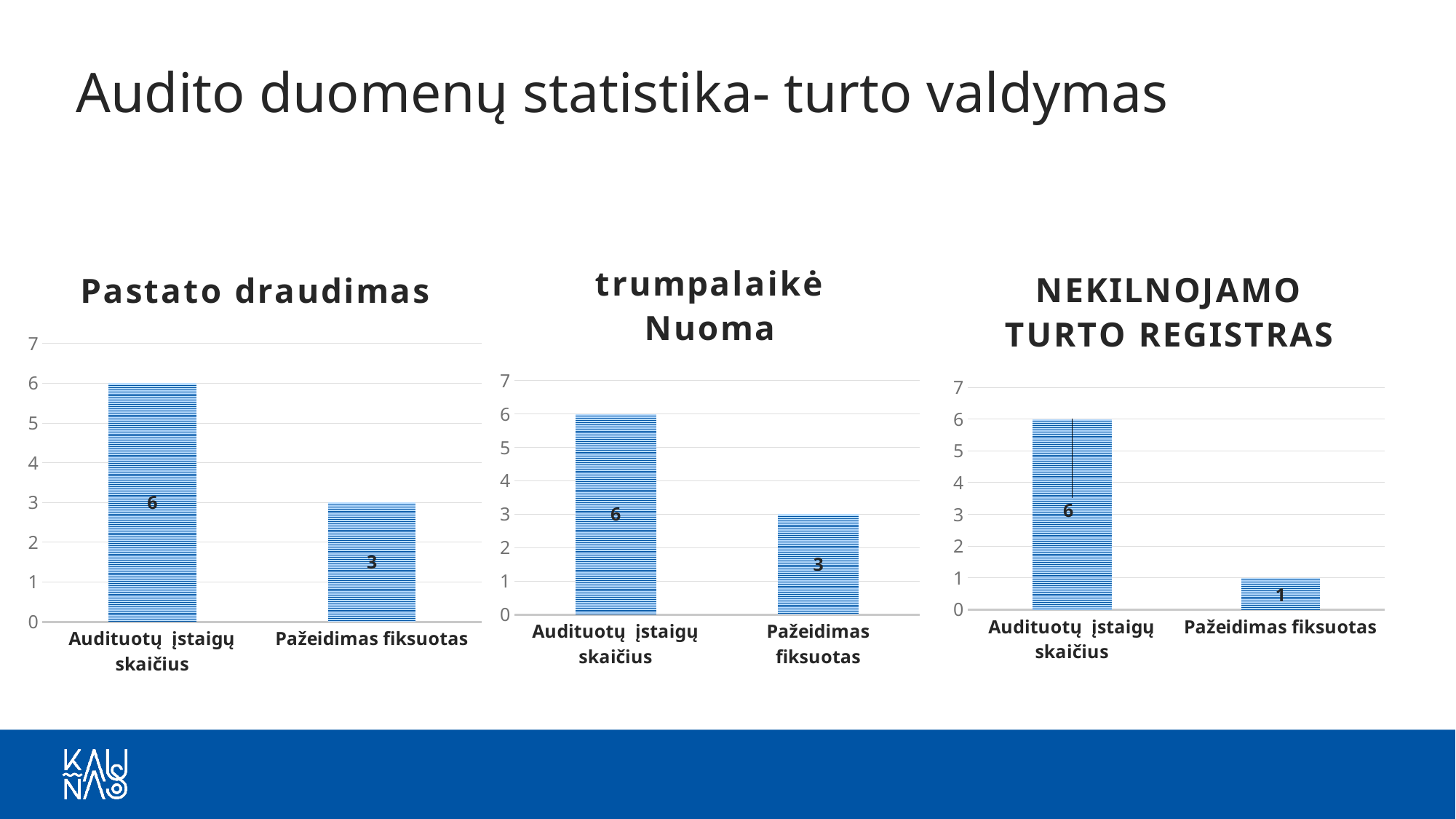
In the 'NEKILNOJAMO TURTO REGISTRAS' chart, what is the value for 'Pažeidimas fiksuotas'? 1 How many categories does the 'Pastato draudimas' chart show? 2 In the 'Pastato draudimas' chart, what is the value for 'Audituotų įstaigų skaičius'? 6 What type of chart is the 'NEKILNOJAMO TURTO REGISTRAS' chart? Bar chart In the 'Pastato draudimas' chart, what is the difference between 'Audituotų įstaigų skaičius' and 'Pažeidimas fiksuotas'? 3 In the 'NEKILNOJAMO TURTO REGISTRAS' chart, what is the difference between 'Audituotų įstaigų skaičius' and 'Pažeidimas fiksuotas'? 5 In the 'Pastato draudimas' chart, what is the value for 'Pažeidimas fiksuotas'? 3 In the 'NEKILNOJAMO TURTO REGISTRAS' chart, which category has the lowest value? Pažeidimas fiksuotas In the 'trumpalaikė Nuoma' chart, which category has the highest value? Audituotų įstaigų skaičius In the 'NEKILNOJAMO TURTO REGISTRAS' chart, what is the value for 'Audituotų įstaigų skaičius'? 6 In the 'trumpalaikė Nuoma' chart, what is the value for 'Pažeidimas fiksuotas'? 3 In the 'trumpalaikė Nuoma' chart, which is larger: 'Audituotų įstaigų skaičius' or 'Pažeidimas fiksuotas'? Audituotų įstaigų skaičius